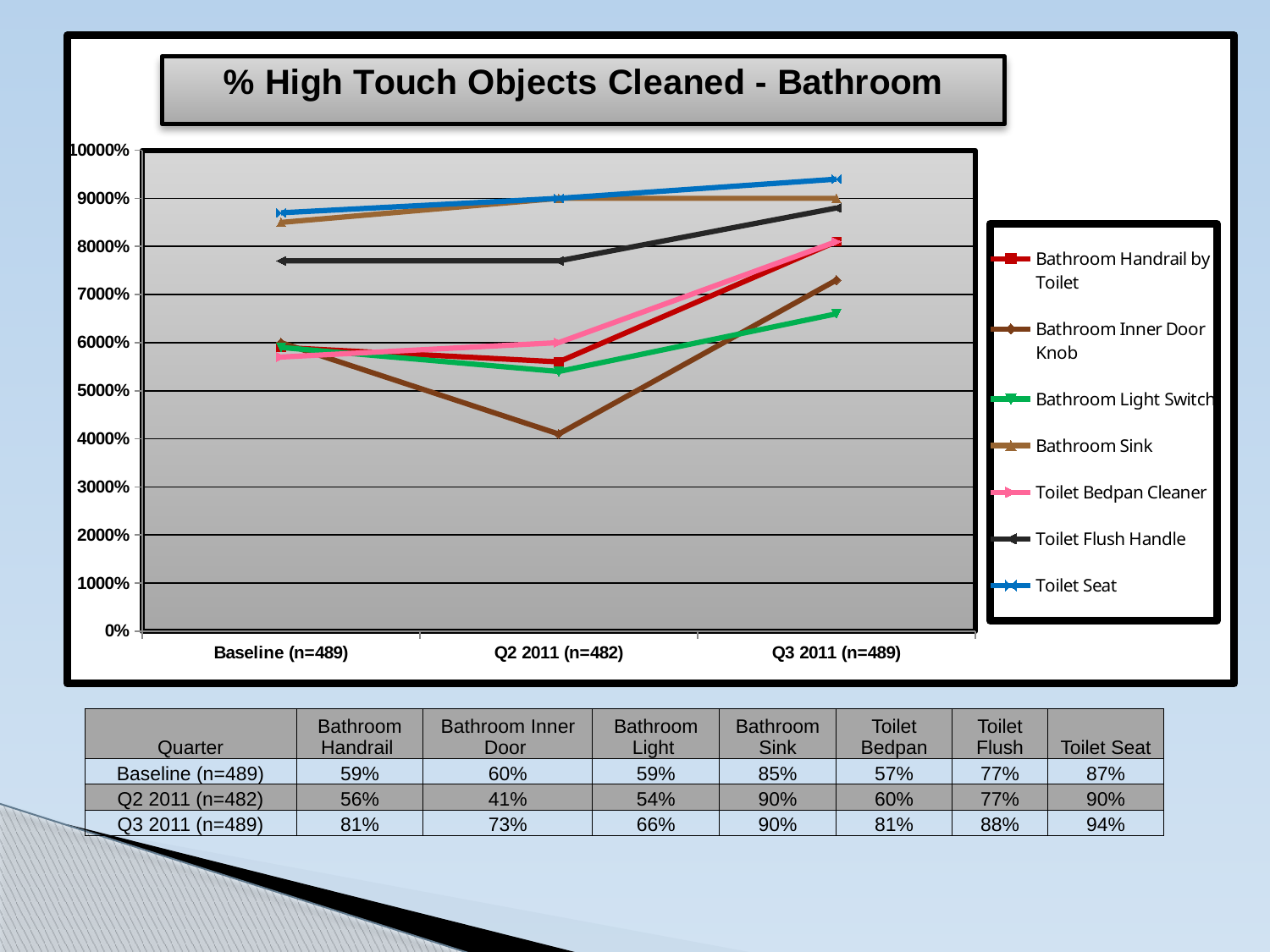
Which series has the highest value at Q3 2011 (n=489)? Toilet Seat What is the title of the chart? % High Touch Objects Cleaned - Bathroom At Baseline (n=489), which is larger: Bathroom Sink or Toilet Flush Handle? Bathroom Sink What kind of chart is shown on the slide? line chart What is the value for Bathroom Inner Door Knob at Q2 2011 (n=482)? 41% What is the value for Bathroom Sink at Baseline (n=489)? 85% How many series does the chart's legend list? 7 How many points along the x axis does each line have? 3 Which series has the lowest value at Q2 2011 (n=482)? Bathroom Inner Door Knob By how many percentage points did Bathroom Handrail by Toilet change from Q2 2011 (n=482) to Q3 2011 (n=489)? 25 Does the Toilet Seat line rise or fall from Baseline to Q3 2011? rise What is the value for Toilet Seat at Q3 2011 (n=489)? 94%